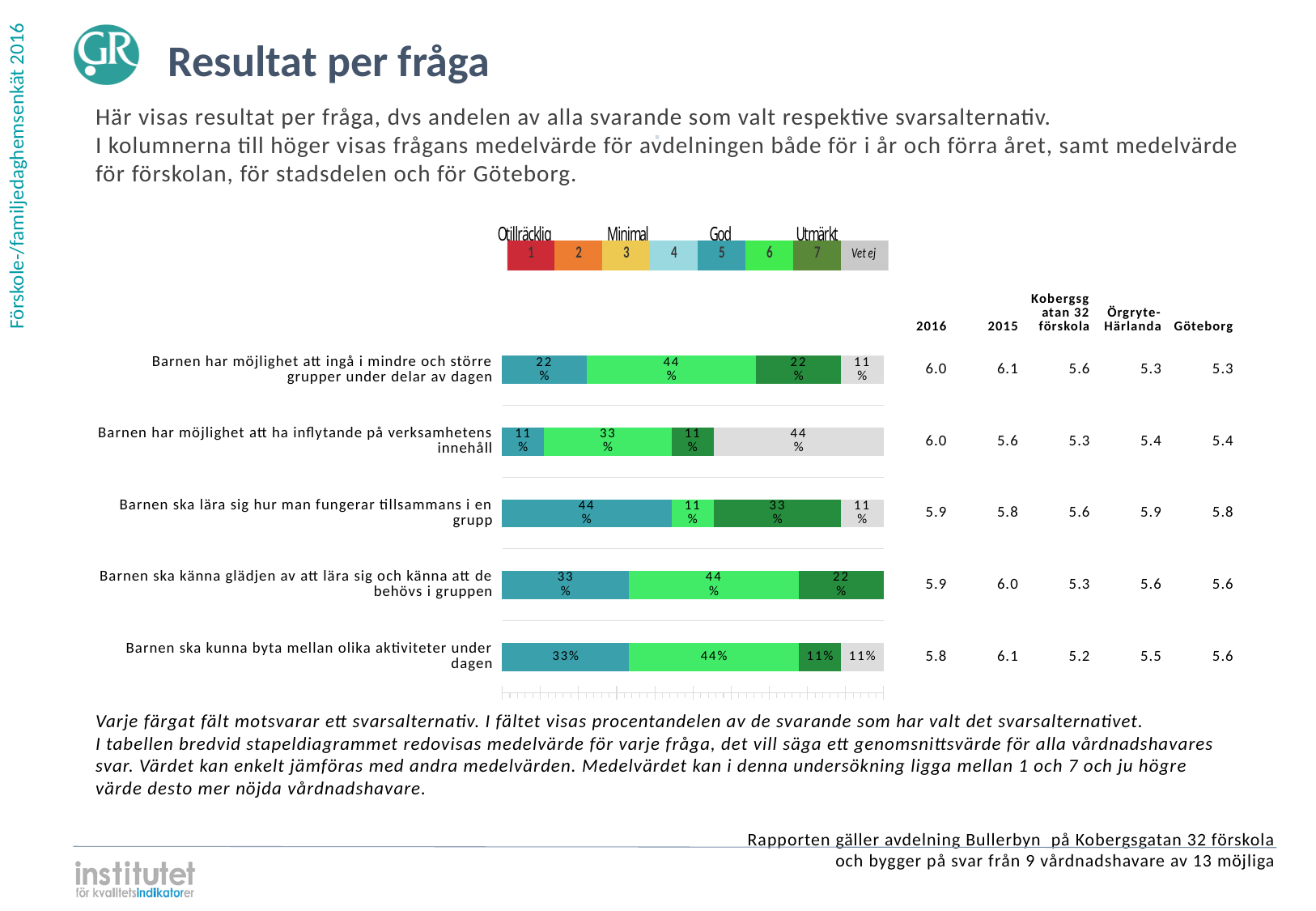
What percentage of respondents chose answer 5 for 'Barnen ska känna glädjen av att lära sig och känna att de behövs i gruppen'? 33% How many questions (bars) are shown in the chart? 5 What percentage of respondents chose 'Vet ej' for 'Barnen har möjlighet att ha inflytande på verksamhetens innehåll'? 44% Which question has the largest 'Vet ej' share? Barnen har möjlighet att ha inflytande på verksamhetens innehåll What is the Göteborg mean value for 'Barnen har möjlighet att ingå i mindre och större grupper under delar av dagen'? 5.3 For 'Barnen ska lära sig hur man fungerar tillsammans i en grupp', which is larger: the share choosing answer 5 or the share choosing answer 7? Answer 5 What percentage of respondents chose answer 6 for 'Barnen ska kunna byta mellan olika aktiviteter under dagen'? 44% Which question has no 'Vet ej' segment in its bar? Barnen ska känna glädjen av att lära sig och känna att de behövs i gruppen What is the difference between the 2016 and 2015 mean values for 'Barnen har möjlighet att ha inflytande på verksamhetens innehåll'? 0.4 What kind of chart is used to show the results per question on this slide? Stacked bar chart What is the 2016 mean value for 'Barnen ska kunna byta mellan olika aktiviteter under dagen'? 5.8 What percentage of respondents chose answer 7 for 'Barnen ska lära sig hur man fungerar tillsammans i en grupp'? 33%